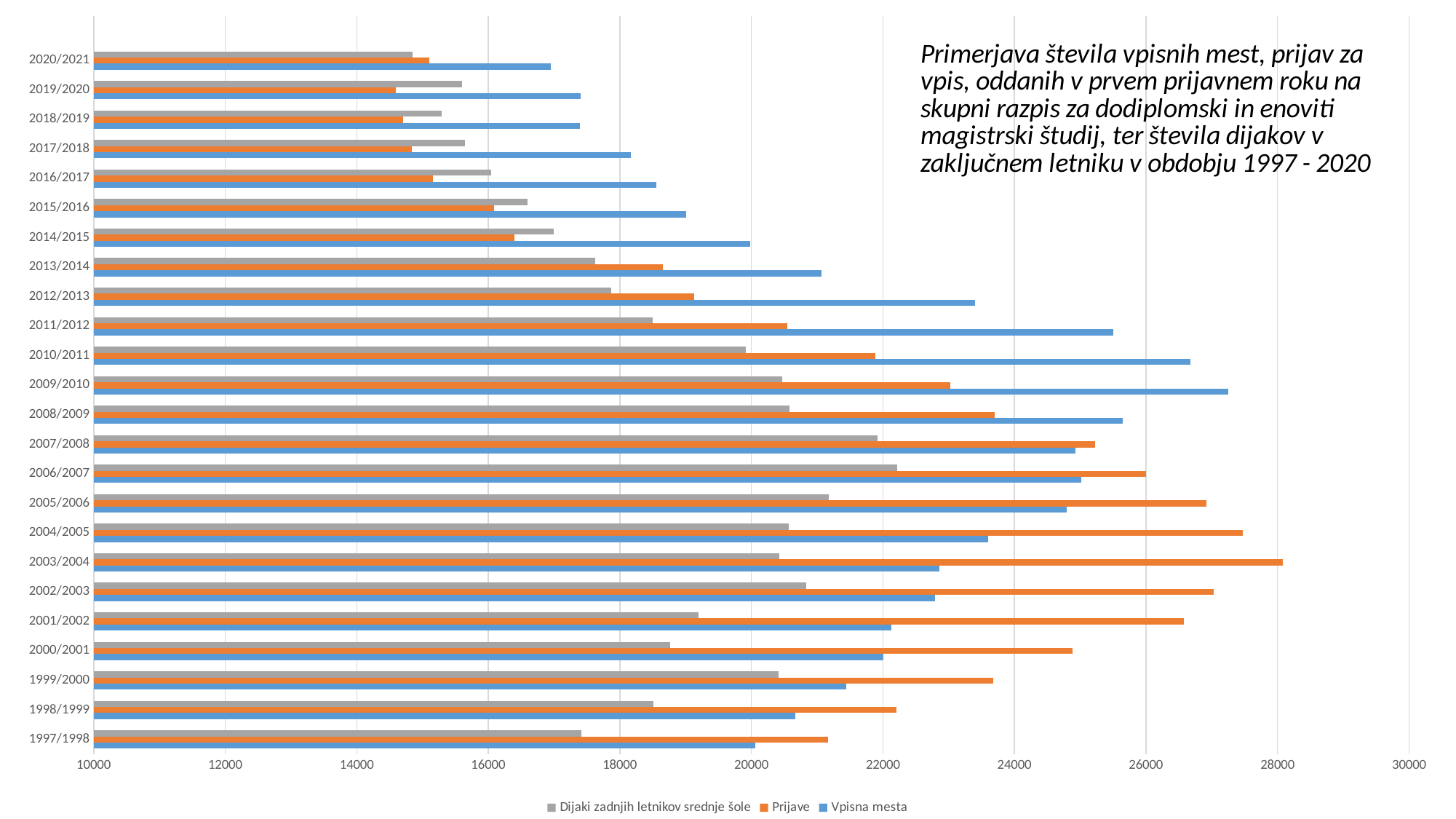
Is the value for Vpisna mesta in 2020/2021 greater or less than 18000? less How many series does the legend list? 3 What kind of chart is shown on the slide? bar chart In 2003/2004, which is larger: Prijave or Vpisna mesta? Prijave In which academic year is the value for Vpisna mesta the lowest? 2020/2021 In which academic year is the value for Vpisna mesta the highest? 2009/2010 Is the value for Prijave in 2003/2004 greater or less than 26000? greater From 2009/2010 to 2020/2021, do the values for Vpisna mesta rise or fall? fall In 2020/2021, which is larger: Vpisna mesta or Prijave? Vpisna mesta In which academic year is the value for Prijave the highest? 2003/2004 How many academic years (categories) are plotted on the chart? 24 In which academic year is the value for Dijaki zadnjih letnikov srednje šole the lowest? 2020/2021